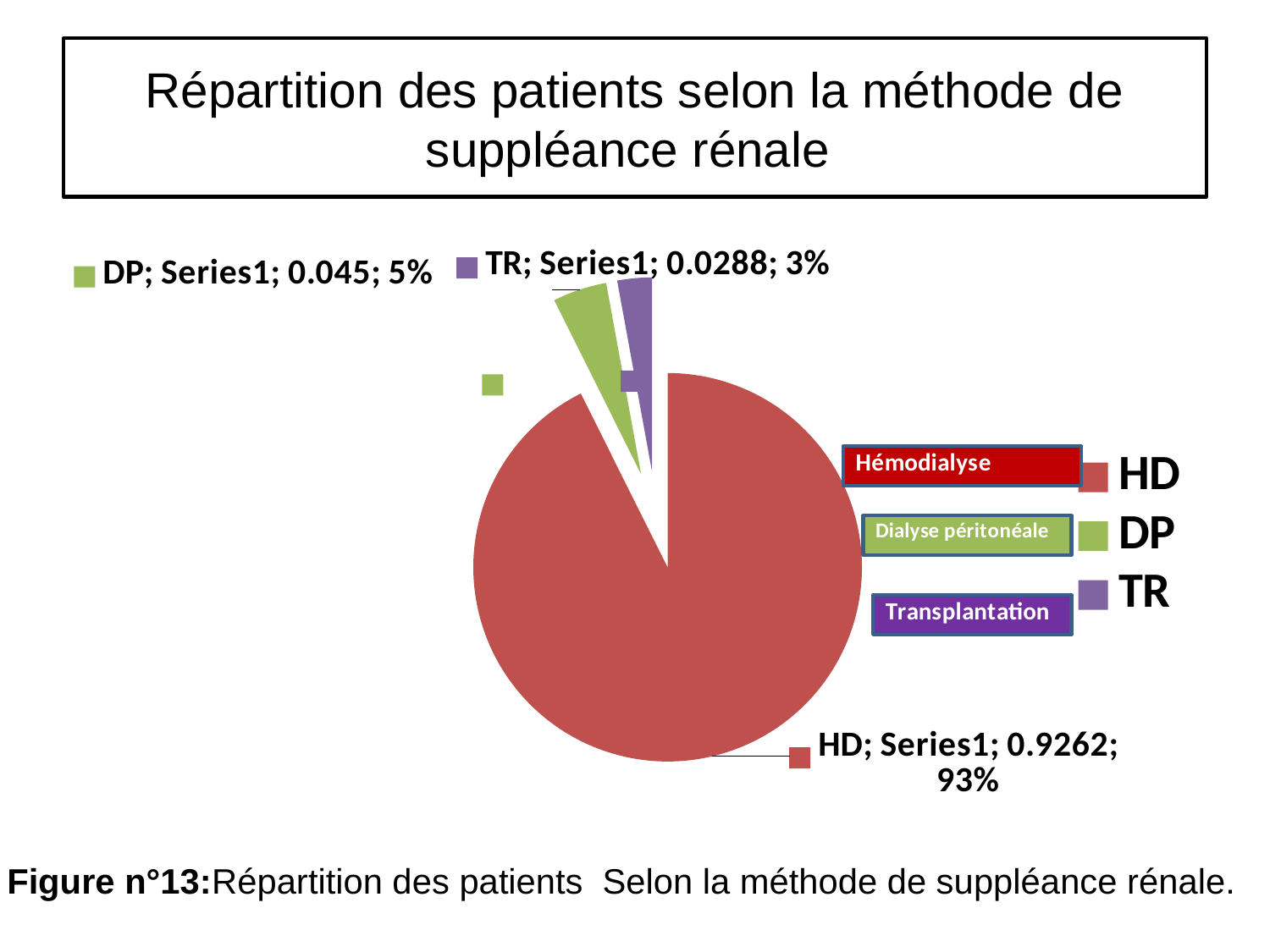
Which is larger, the share for DP or the share for TR? DP What percentage share does HD have in the pie chart? 93% What is the title of the chart? Répartition des patients selon la méthode de suppléance rénale What value is printed for DP in the data label? 0.045 Which category has the smallest slice of the pie? TR What percentage share does DP have in the pie chart? 5% Which category has the largest slice of the pie? HD What percentage share does TR have in the pie chart? 3% What kind of chart is shown on the slide? pie chart How many categories are shown in the pie chart? 3 What value is printed for HD in the data label? 0.9262 What value is printed for TR in the data label? 0.0288